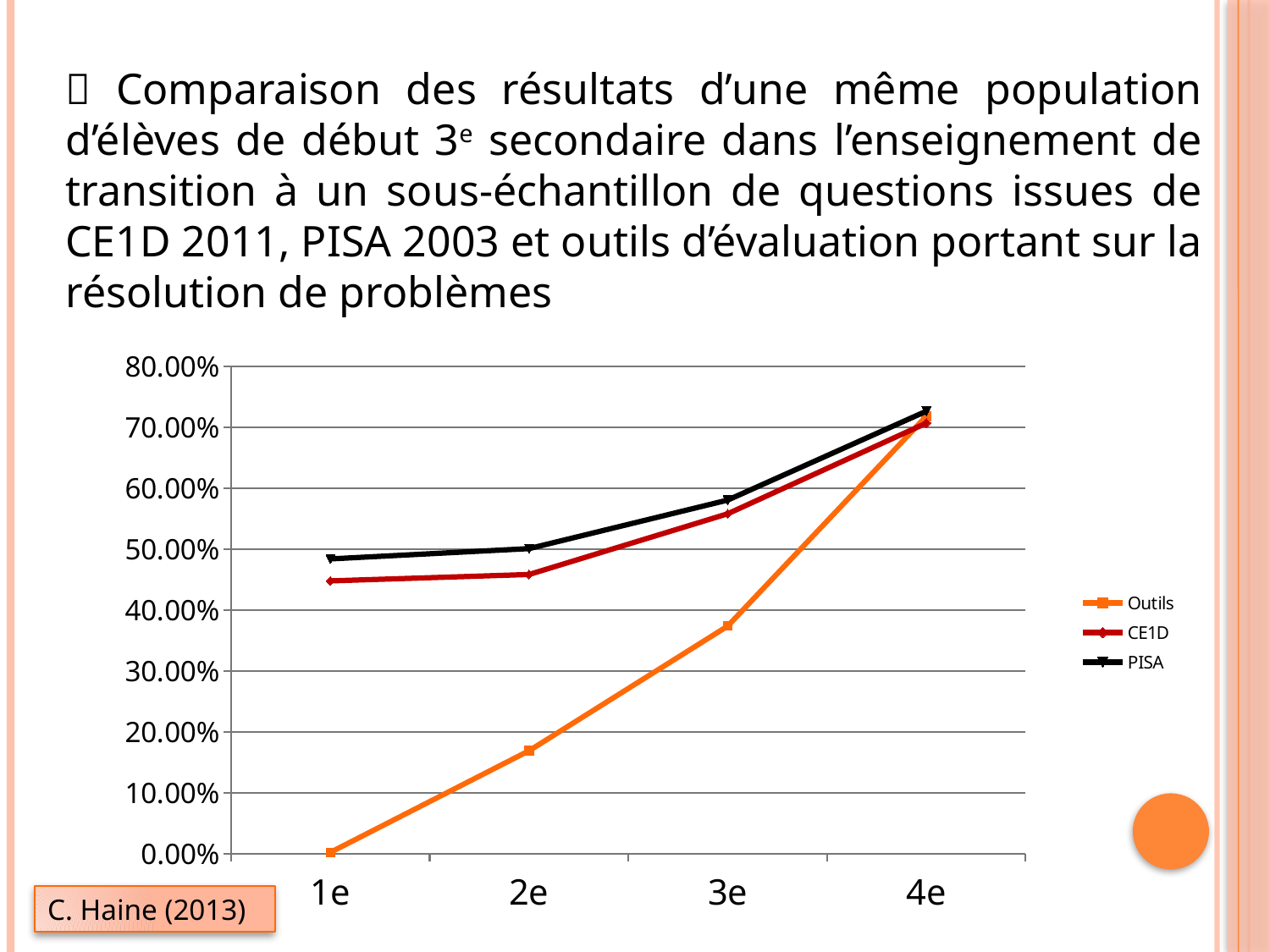
Is the value for CE1D at 1e greater or less than 50.00%? less How many series does the legend list? 3 Which series has the lowest value at 1e? Outils At 3e, which is larger: the value for PISA or the value for Outils? PISA How many categories are shown on the x axis? 4 Which series has the highest value at 1e? PISA Is the value for PISA at 3e greater or less than 50.00%? greater What kind of chart is shown on the slide? line chart Is the value for Outils at 3e greater or less than 30.00%? greater Do the values for Outils rise or fall from 1e to 4e? rise Which series is drawn in orange in the legend? Outils